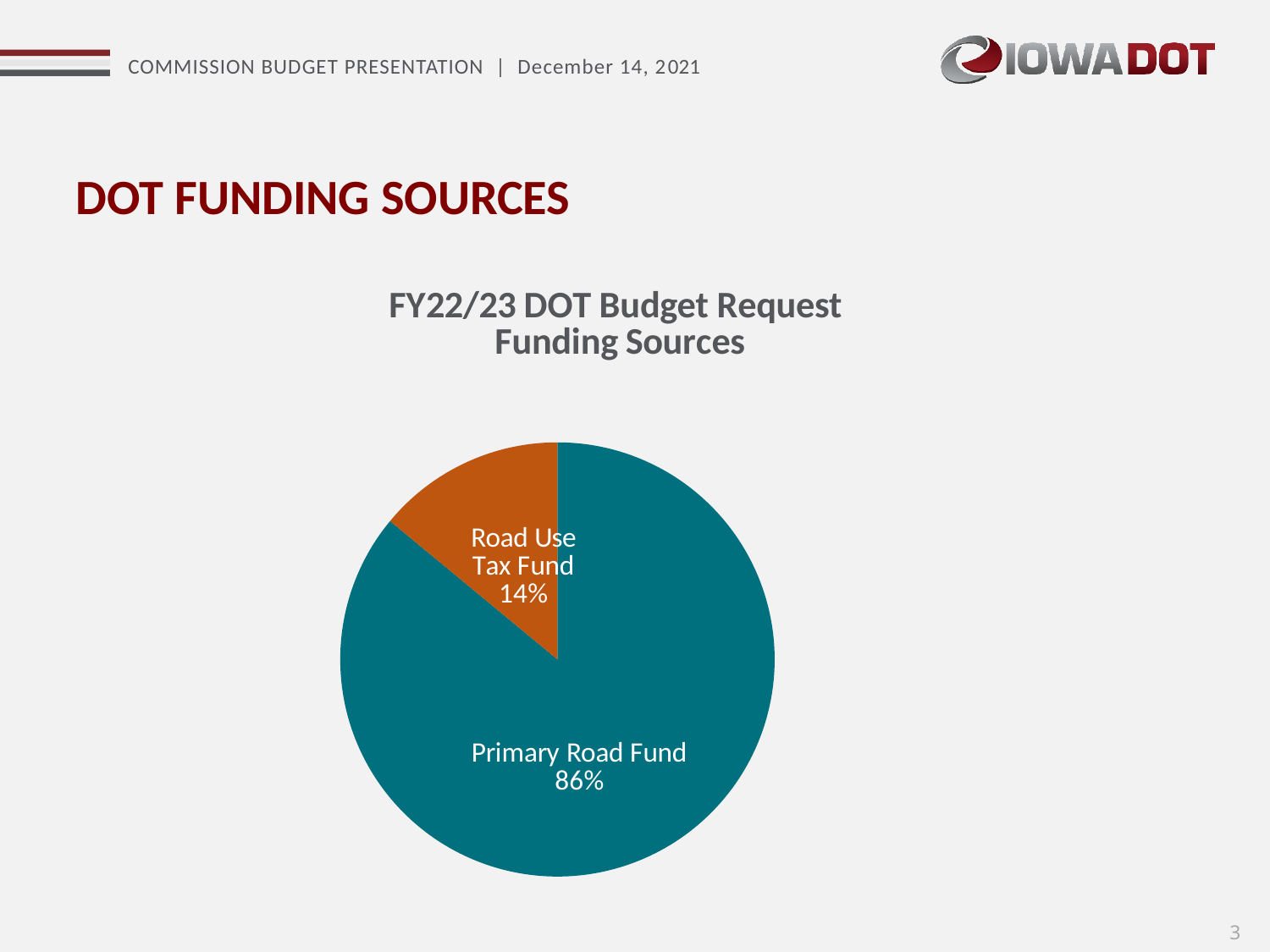
What is the difference in percentage points between the Primary Road Fund and the Road Use Tax Fund shares? 72 What kind of chart is shown on the slide? Pie chart What share of the pie does the Primary Road Fund represent? 86% Which funding source has the largest slice of the pie? Primary Road Fund How many slices does the pie chart have? 2 What is the title of the chart? FY22/23 DOT Budget Request Funding Sources Which is larger, the Road Use Tax Fund share or the Primary Road Fund share? Primary Road Fund What colour is the Road Use Tax Fund slice? Orange What share of the pie does the Road Use Tax Fund represent? 14% Which funding source has the smallest slice of the pie? Road Use Tax Fund